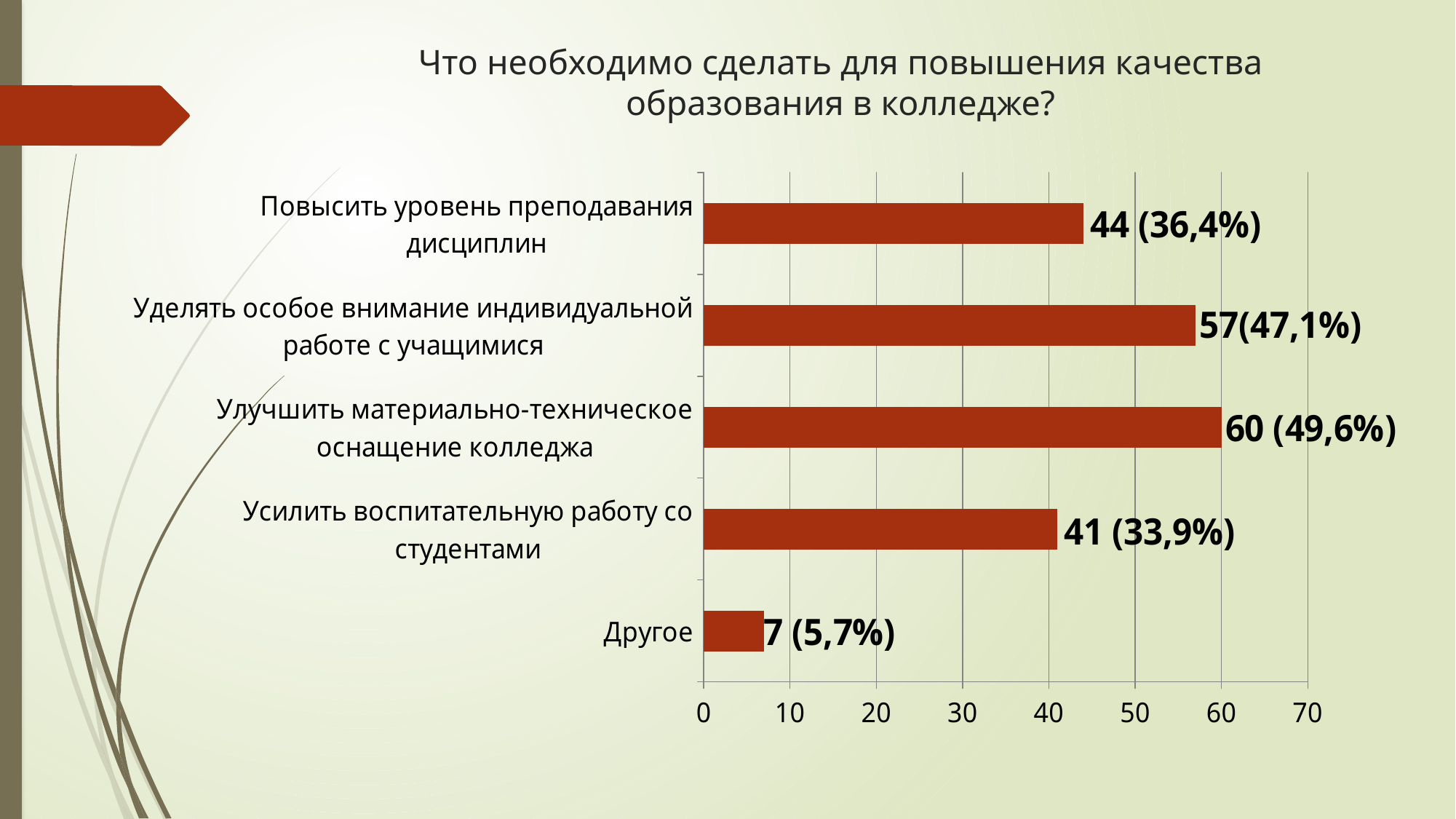
Which is larger: the value for "Повысить уровень преподавания дисциплин" or for "Усилить воспитательную работу со студентами"? Повысить уровень преподавания дисциплин Is the value for "Уделять особое внимание индивидуальной работе с учащимися" greater or less than 50? greater Which category has the highest value? Улучшить материально-техническое оснащение колледжа How many categories are shown in the chart? 5 What kind of chart is shown on the slide? bar chart What is the value for "Улучшить материально-техническое оснащение колледжа"? 60 (49,6%) What is the value for "Повысить уровень преподавания дисциплин"? 44 (36,4%) What is the highest value shown on the x axis? 70 What is the title of the slide? Что необходимо сделать для повышения качества образования в колледже? What is the value for "Другое"? 7 (5,7%) Which category has the lowest value? Другое What is the difference between the counts for "Уделять особое внимание индивидуальной работе с учащимися" and "Усилить воспитательную работу со студентами"? 16